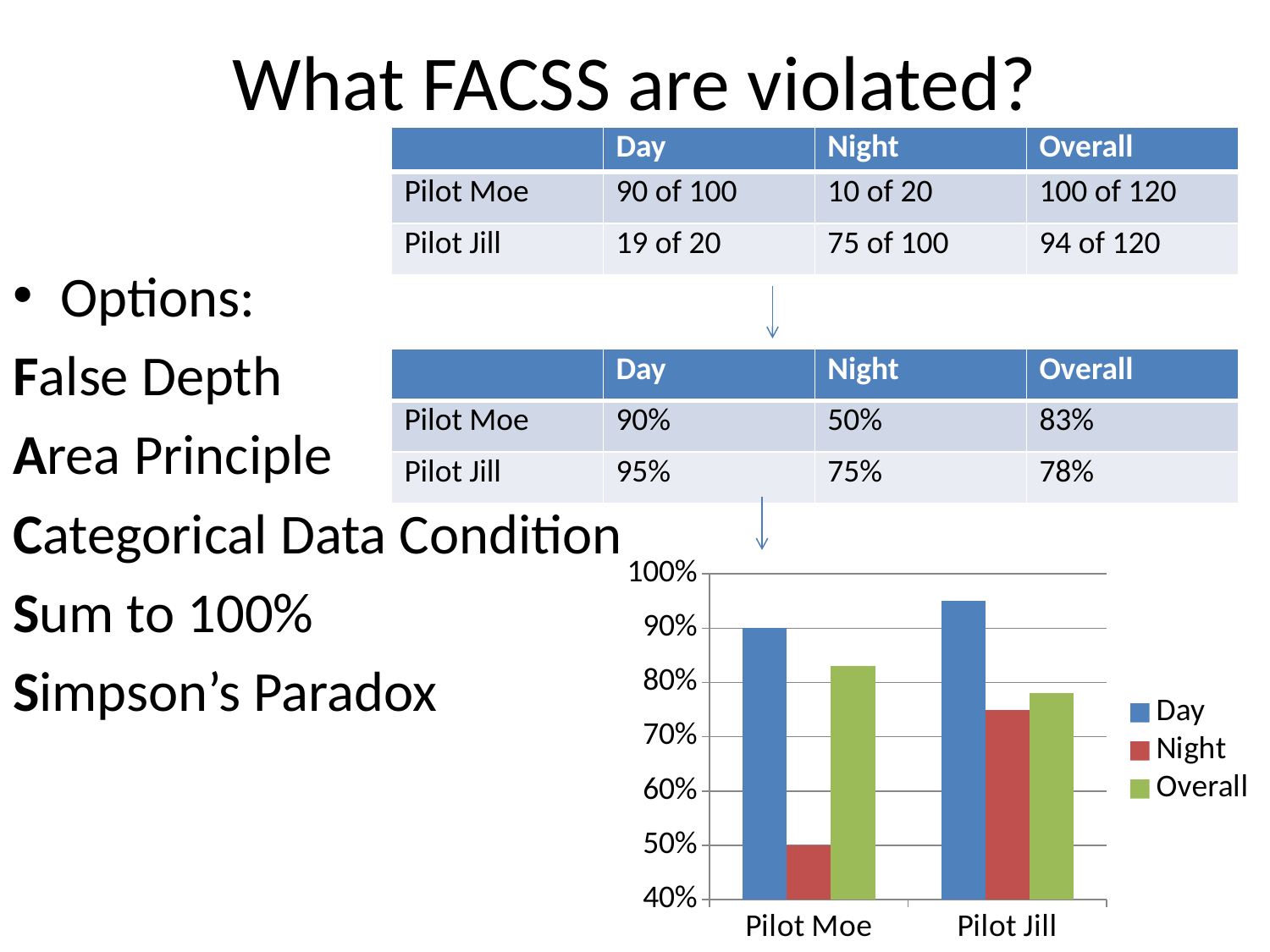
What kind of chart is shown on the slide? bar chart What is the Day value for Pilot Moe in the chart? 90% Is the Night value for Pilot Jill greater or less than 80%? less Which series has the lowest value for Pilot Moe? Night Which series has the highest value for Pilot Jill? Day What is the Overall value for Pilot Jill in the chart? 78% How many categories are shown on the x axis of the chart? 2 How many series does the chart legend list? 3 What is the difference between the Night values for Pilot Jill and Pilot Moe? 25% Is the Day value for Pilot Jill greater or less than 90%? greater Which is larger, the Overall value for Pilot Moe or the Overall value for Pilot Jill? Pilot Moe What is the Night value for Pilot Moe in the chart? 50%